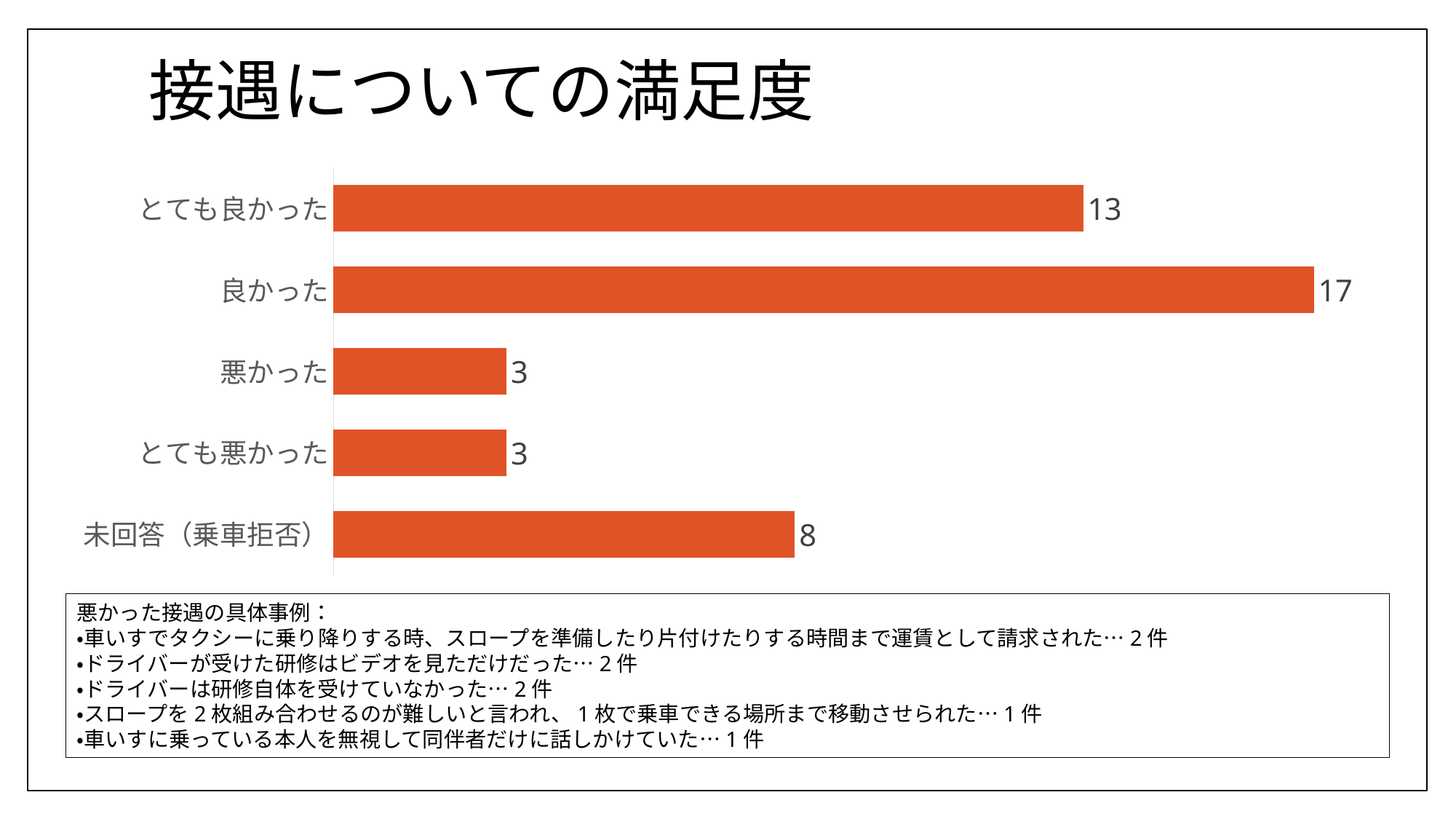
What colour are the bars in the chart? Orange How many categories are shown in the chart? 5 What is the difference between the values for 良かった and とても良かった? 4 What is the difference between the values for 未回答（乗車拒否） and 悪かった? 5 What kind of chart is shown on the slide? Bar chart What is the value for とても良かった? 13 What is the value for 未回答（乗車拒否）? 8 Which is larger, the value for とても良かった or the value for 未回答（乗車拒否）? とても良かった What is the title of the slide? 接遇についての満足度 Which category has the highest value? 良かった What is the value for 良かった? 17 What is the value for 悪かった? 3